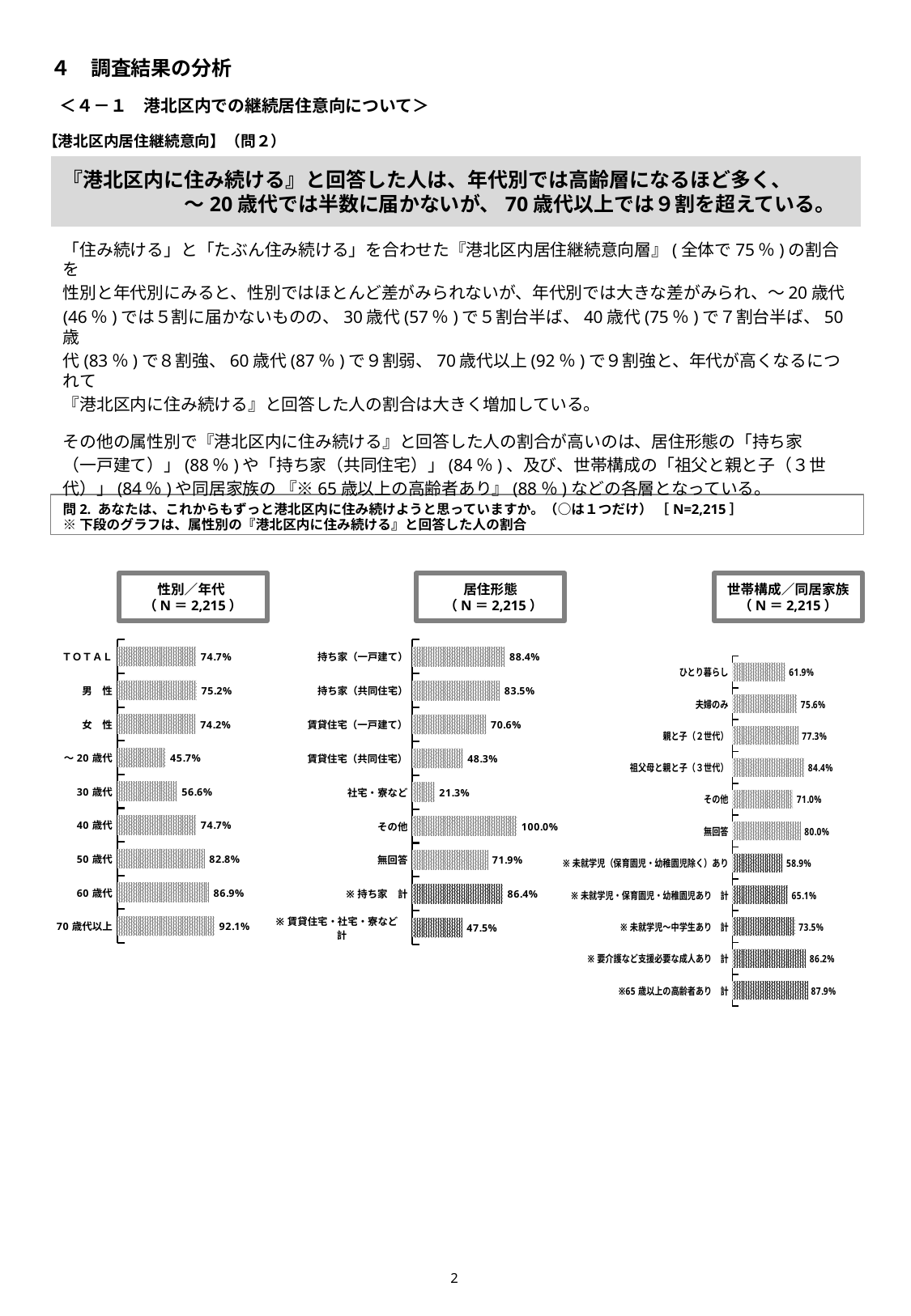
In the 性別／年代 chart, do the values rise or fall going from ～20歳代 to 70歳代以上? rise How many categories are shown in the 性別／年代 chart? 9 In the 居住形態 chart, which category has the highest value? その他 What kind of chart is the 居住形態 chart? bar chart In the 居住形態 chart, which is larger, 持ち家（一戸建て） or 持ち家（共同住宅）? 持ち家（一戸建て） In the 世帯構成／同居家族 chart, what is the value for 祖父母と親と子（3世代）? 84.4% How many categories are shown in the 世帯構成／同居家族 chart? 11 In the 世帯構成／同居家族 chart, which category has the highest value? ※65歳以上の高齢者あり 計 In the 性別／年代 chart, which category has the lowest value? ～20歳代 In the 性別／年代 chart, what is the difference between 60歳代 and 30歳代? 30.3 percentage points In the 居住形態 chart, what is the value for 社宅・寮など? 21.3% In the 性別／年代 chart, what is the value for 70歳代以上? 92.1%